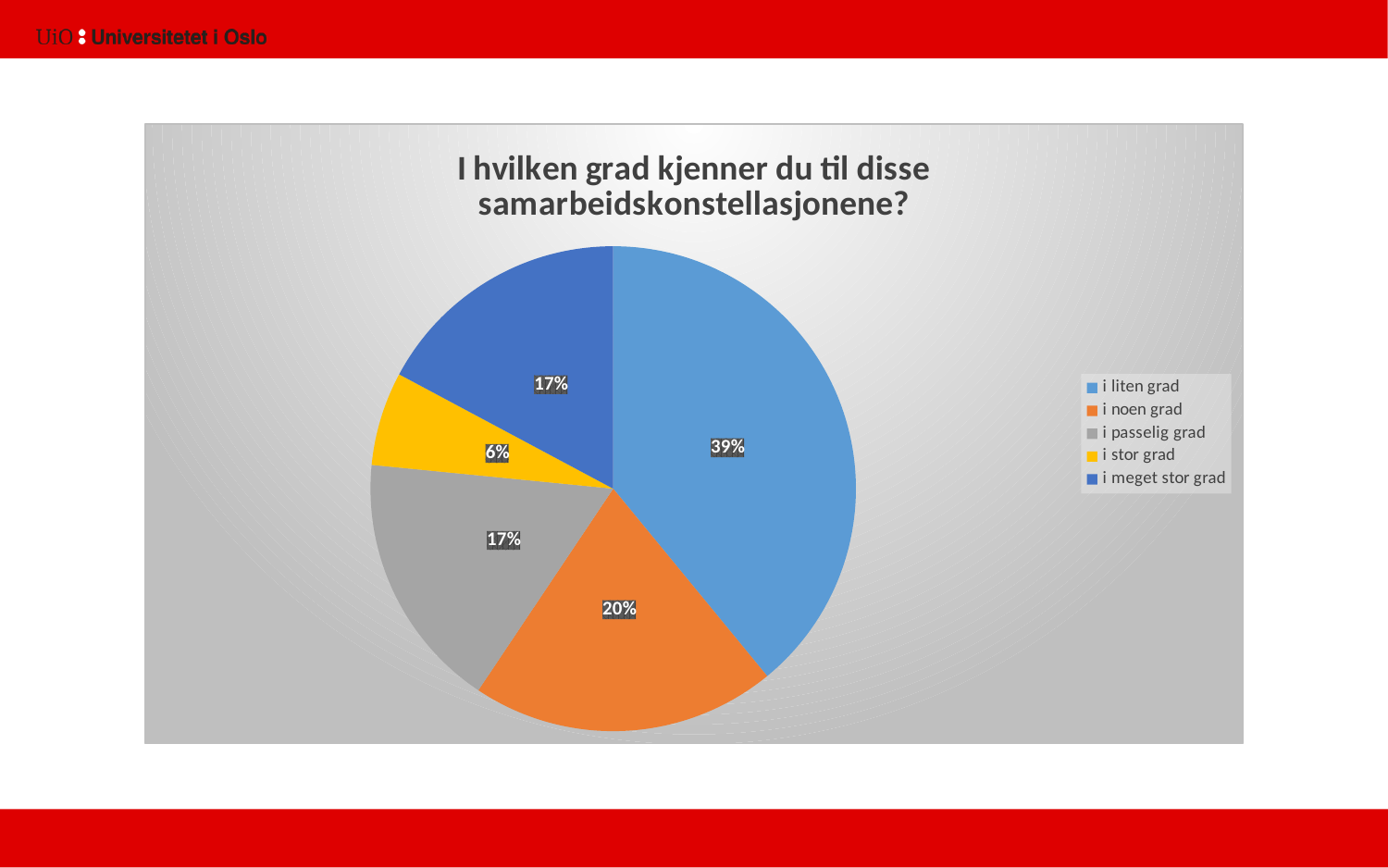
What kind of chart is shown on the slide? pie chart What share of the pie is 'i stor grad'? 6% Which category has the largest slice of the pie? i liten grad What is the difference in percentage points between 'i liten grad' and 'i noen grad'? 19 Which category has the smallest slice of the pie? i stor grad How many categories does the legend list? 5 What colour is the slice for 'i stor grad'? yellow What share of the pie is 'i noen grad'? 20% What share of the pie is 'i passelig grad'? 17% Which is larger, the slice for 'i noen grad' or the slice for 'i stor grad'? i noen grad What is the title of the chart? I hvilken grad kjenner du til disse samarbeidskonstellasjonene?